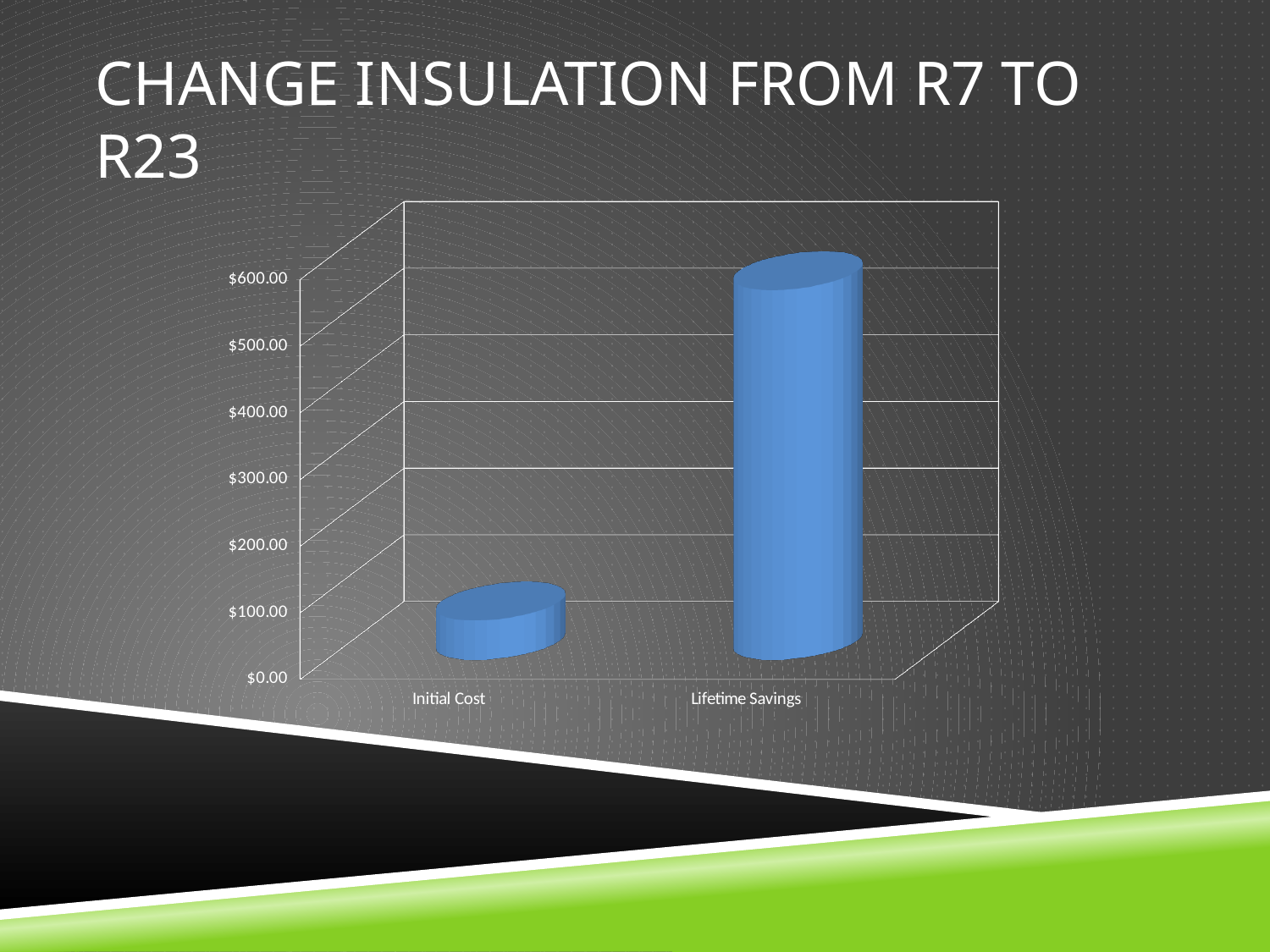
Which category has the highest value? Lifetime Savings What is the title of the slide containing the chart? CHANGE INSULATION FROM R7 TO R23 What is the highest value labelled on the vertical axis? $600.00 Which category has the lowest value? Initial Cost How many categories are plotted on the chart? 2 Is the value for Initial Cost greater or less than $200.00? less Is the value for Initial Cost greater or less than $300.00? less Is the value for Lifetime Savings greater or less than $400.00? greater Which is larger, Initial Cost or Lifetime Savings? Lifetime Savings What kind of chart is shown on the slide? bar chart